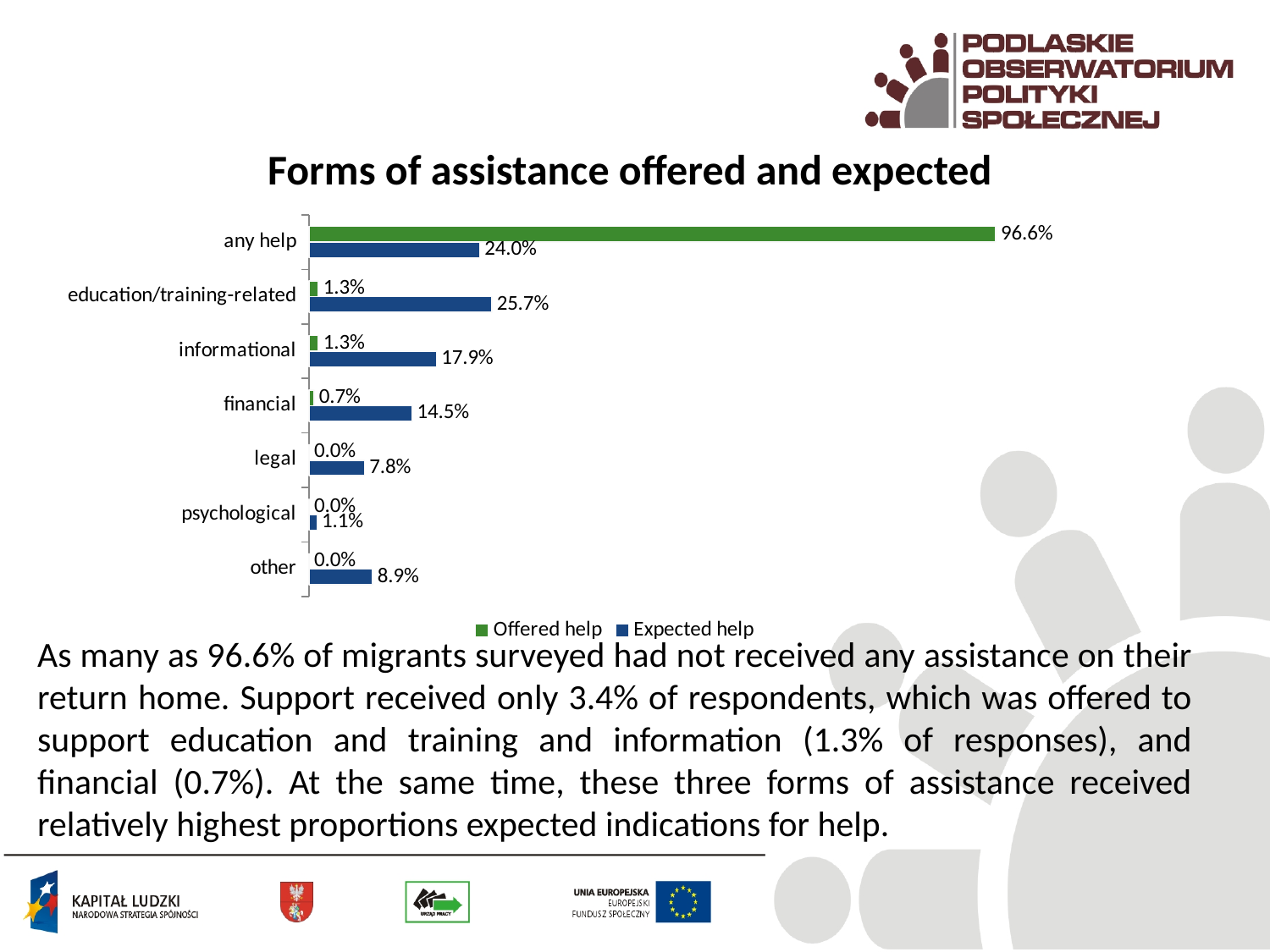
What is the Expected help value for education/training-related? 25.7% What is the title of the chart? Forms of assistance offered and expected How many series does the legend list? 2 What is the Offered help value for any help? 96.6% How many categories are shown on the chart? 7 Which category has the lowest Expected help value? psychological Which is larger, the Expected help value for other or for legal? other What is the Offered help value for financial? 0.7% What is the Expected help value for legal? 7.8% What is the difference between the Expected help values for informational and financial? 3.4% Which category has the highest Expected help value? education/training-related What kind of chart is shown on the slide? bar chart